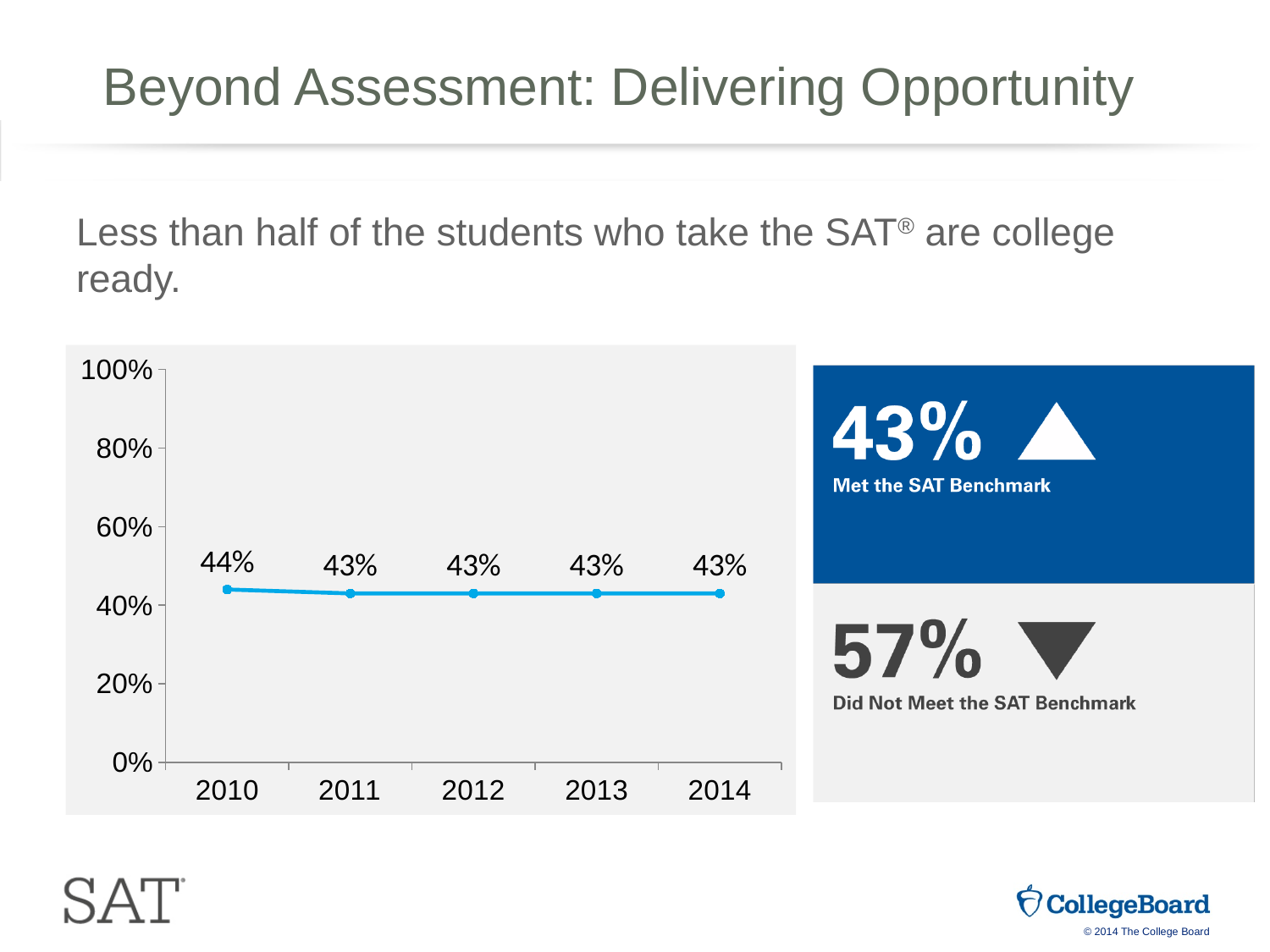
What kind of chart is shown? line chart Which year has the highest value? 2010 What is the highest value shown on the y axis? 100% What percentage of students did not meet the SAT Benchmark, according to the panel to the right of the chart? 57% Is the value for 2013 greater or less than 60%? less Is the value for 2010 greater or less than 20%? greater How many years are plotted on the x axis? 5 What is the value for 2014? 43% Do the values rise, fall, or stay roughly flat from 2011 to 2014? stay flat What is the value for 2012? 43% What is the difference between the values for 2010 and 2011? 1% What is the value for 2010? 44%